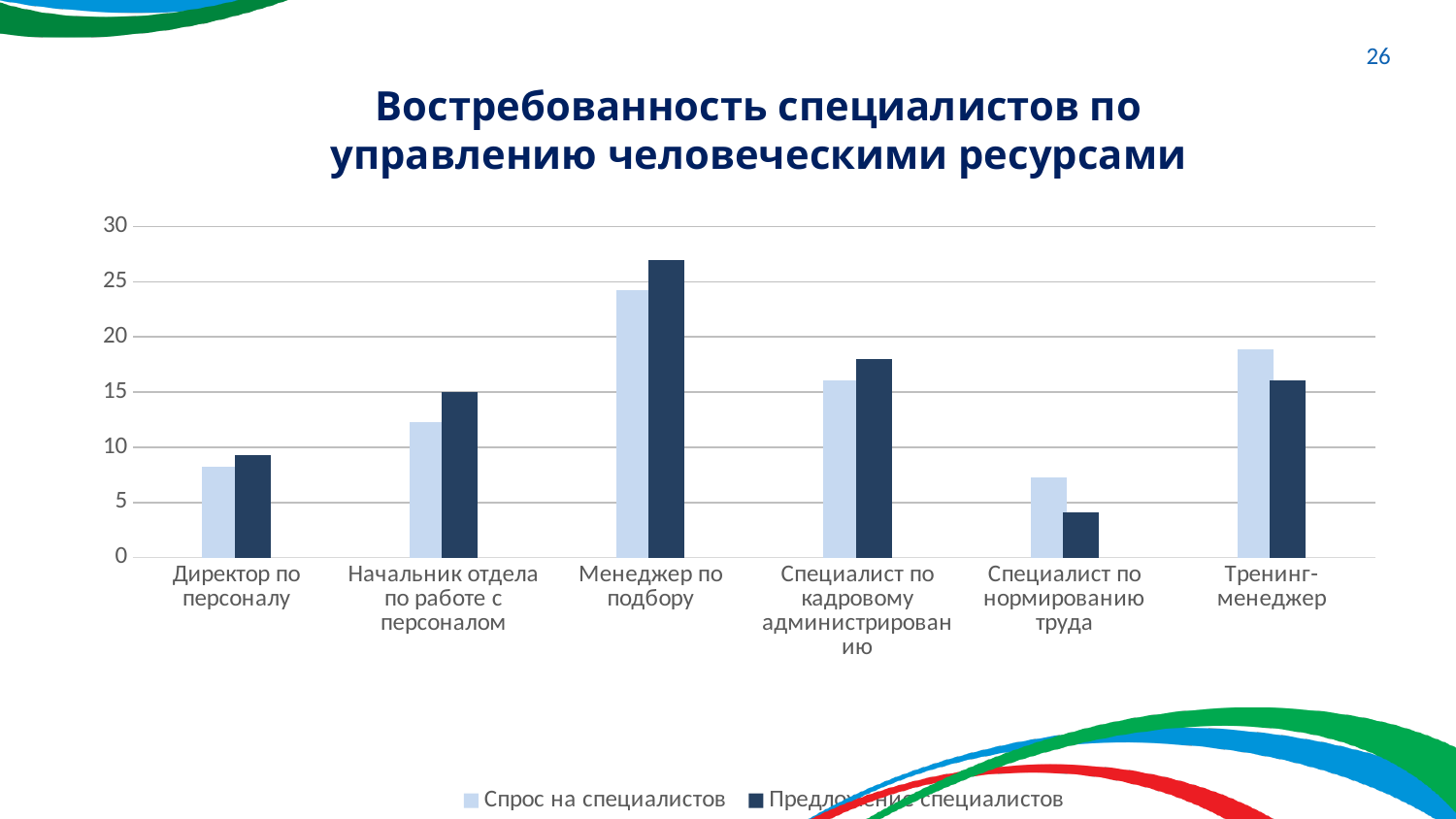
Which category has the lowest value for 'Предложение специалистов'? Специалист по нормированию труда Which category has the lowest value for 'Спрос на специалистов'? Специалист по нормированию труда Is the value of 'Предложение специалистов' for 'Специалист по нормированию труда' greater or less than 5? less Is the value of 'Спрос на специалистов' for 'Менеджер по подбору' greater or less than 20? greater Which category has the highest value for 'Спрос на специалистов'? Менеджер по подбору Which category has the highest value for 'Предложение специалистов'? Менеджер по подбору How many job categories are shown on the x axis of the chart? 6 What is the title of the chart on the slide? Востребованность специалистов по управлению человеческими ресурсами For 'Директор по персоналу', which is larger: 'Спрос на специалистов' or 'Предложение специалистов'? Предложение специалистов What kind of chart is shown on the slide? Bar chart For 'Тренинг-менеджер', which is larger: 'Спрос на специалистов' or 'Предложение специалистов'? Спрос на специалистов How many series does the chart legend list? 2